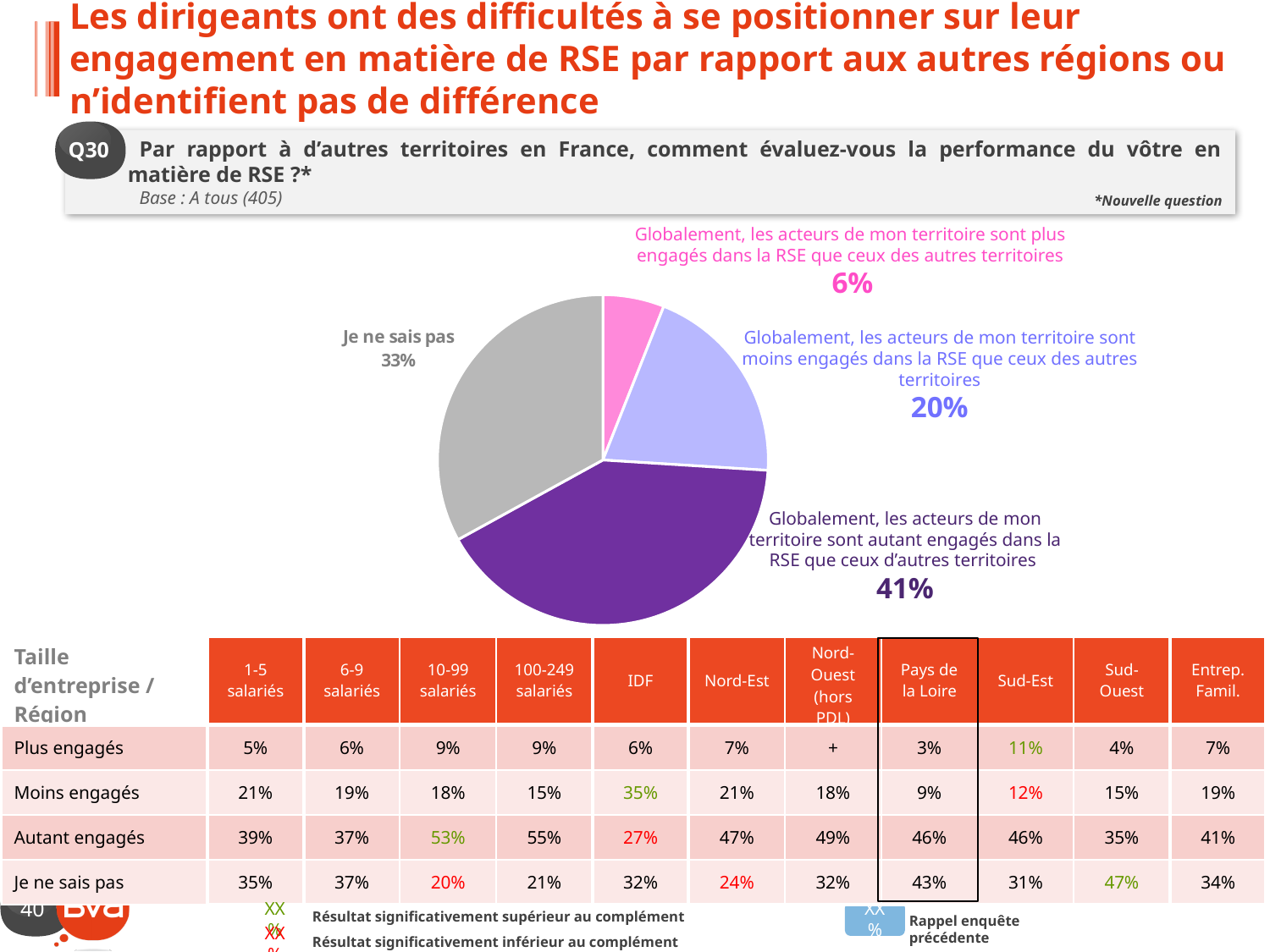
How many slices does the pie chart have? 4 Which is larger: the share for 'Je ne sais pas' or the share for 'moins engagés'? Je ne sais pas (33%) What is the combined share of 'plus engagés' and 'moins engagés'? 26% Which slice of the pie chart is the largest? Globalement, les acteurs de mon territoire sont autant engagés dans la RSE que ceux d'autres territoires (41%) What share of the pie is 'Je ne sais pas'? 33% What colour is the 'Je ne sais pas' slice of the pie chart? grey What is the difference in percentage points between 'autant engagés' (41%) and 'moins engagés' (20%)? 21 percentage points What percentage of respondents say the actors of their territory are as engaged in CSR as those of other territories (autant engagés)? 41% What percentage of respondents say the actors of their territory are less engaged in CSR than those of other territories (moins engagés)? 20% Which slice of the pie chart is the smallest? Globalement, les acteurs de mon territoire sont plus engagés dans la RSE que ceux des autres territoires (6%) What percentage of respondents say the actors of their territory are more engaged in CSR than those of other territories (plus engagés)? 6% What kind of chart is shown on the slide? pie chart